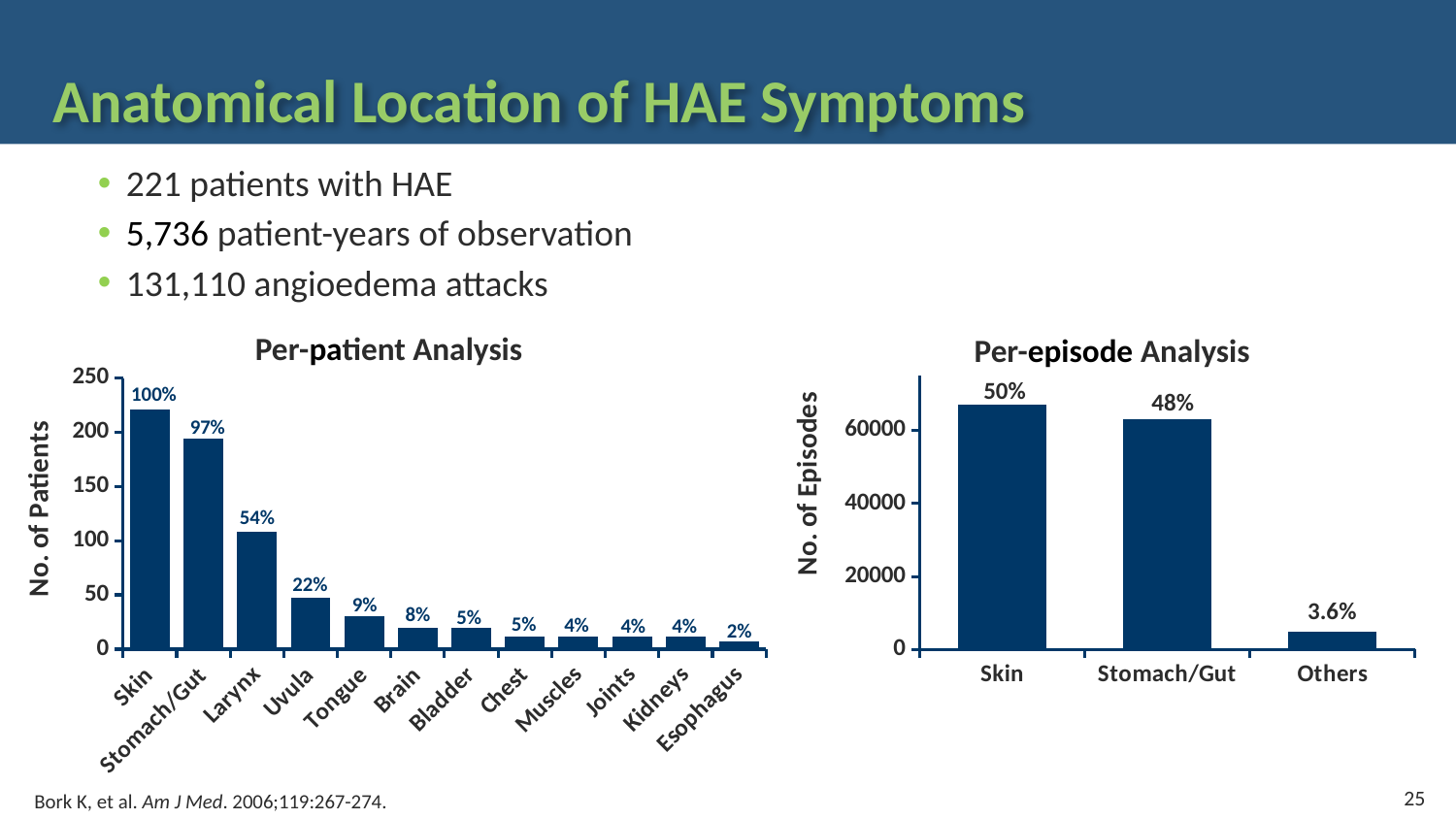
What is the y-axis label of the Per-episode Analysis chart? No. of Episodes In the Per-episode Analysis chart, is the number of episodes for Skin greater or less than 60000? greater In the Per-patient Analysis chart, how many anatomical locations are shown on the x axis? 12 What type of chart is the Per-patient Analysis chart? bar chart In the Per-episode Analysis chart, what percentage label is shown for Others? 3.6% In the Per-patient Analysis chart, which location has the lowest number of patients? Esophagus In the Per-patient Analysis chart, what percentage label is shown for Uvula? 22% In the Per-patient Analysis chart, is the number of patients for Tongue greater or less than 50? less In the Per-patient Analysis chart, which location has the highest number of patients? Skin In the Per-patient Analysis chart, what is the difference between the percentage labels for Skin and Stomach/Gut? 3% In the Per-patient Analysis chart, is the number of patients for Skin greater or less than 200? greater In the Per-patient Analysis chart, what percentage label is shown for Larynx? 54%